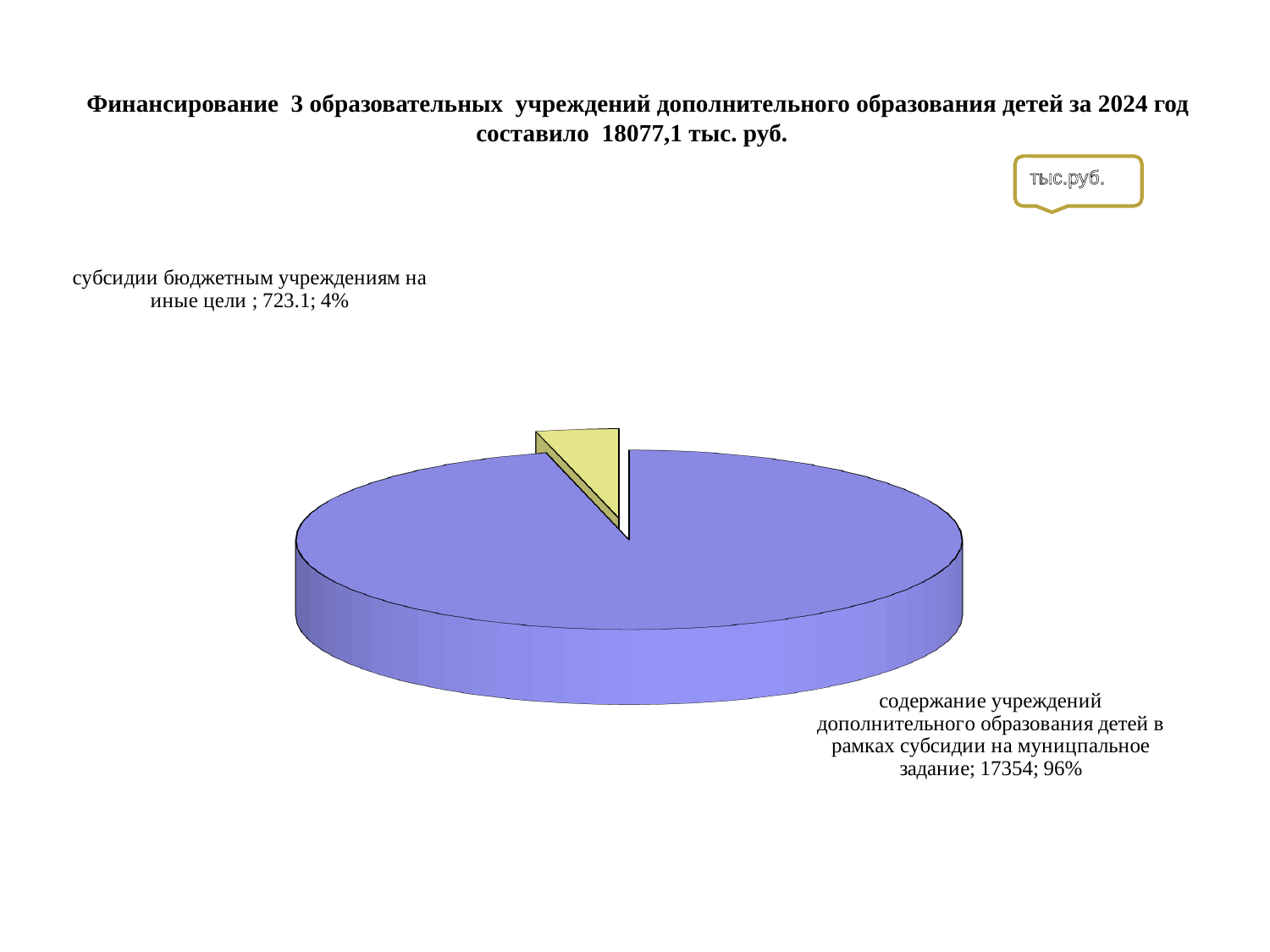
What unit of measurement is indicated in the callout box on the slide? тыс.руб. Which slice of the pie chart is the largest? содержание учреждений дополнительного образования детей в рамках субсидии на муниципальное задание What share of the pie does "субсидии бюджетным учреждениям на иные цели" represent? 4% According to the slide title, what was the total financing of the 3 institutions of additional education for children in 2024? 18077,1 тыс. руб. What is the difference between the value for "содержание учреждений дополнительного образования детей в рамках субсидии на муниципальное задание" and the value for "субсидии бюджетным учреждениям на иные цели"? 16630.9 How many slices does the pie chart have? 2 What kind of chart is shown on the slide? pie chart What is the value for "содержание учреждений дополнительного образования детей в рамках субсидии на муниципальное задание"? 17354 Which is larger: the value for "субсидии бюджетным учреждениям на иные цели" or the value for "содержание учреждений дополнительного образования детей в рамках субсидии на муниципальное задание"? содержание учреждений дополнительного образования детей в рамках субсидии на муниципальное задание What share of the pie does "содержание учреждений дополнительного образования детей в рамках субсидии на муниципальное задание" represent? 96% Which slice of the pie chart is the smallest? субсидии бюджетным учреждениям на иные цели What is the value for "субсидии бюджетным учреждениям на иные цели"? 723.1